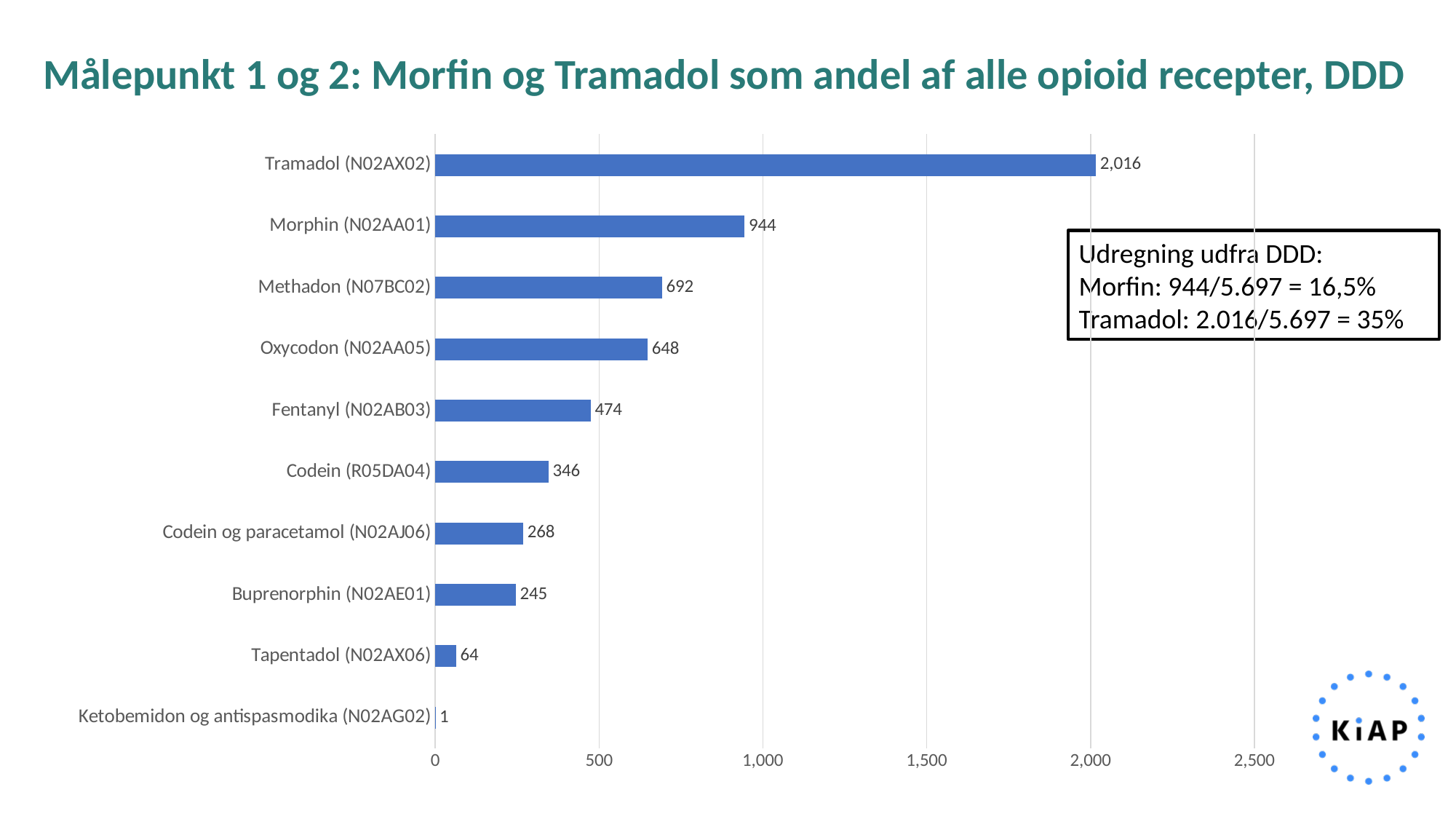
Is the value for Codein (R05DA04) greater or less than 500? less What kind of chart is shown on the slide? bar chart Which is larger, the value for Methadon (N07BC02) or Oxycodon (N02AA05)? Methadon (N07BC02) What is the value for Tramadol (N02AX02)? 2,016 What is the value for Tapentadol (N02AX06)? 64 What is the value for Morphin (N02AA01)? 944 Which category has the lowest value? Ketobemidon og antispasmodika (N02AG02) What is the difference between the values for Tramadol (N02AX02) and Morphin (N02AA01)? 1,072 What is the value for Fentanyl (N02AB03)? 474 Which category has the highest value? Tramadol (N02AX02) What is the title of the slide? Målepunkt 1 og 2: Morfin og Tramadol som andel af alle opioid recepter, DDD How many categories are shown in the chart? 10